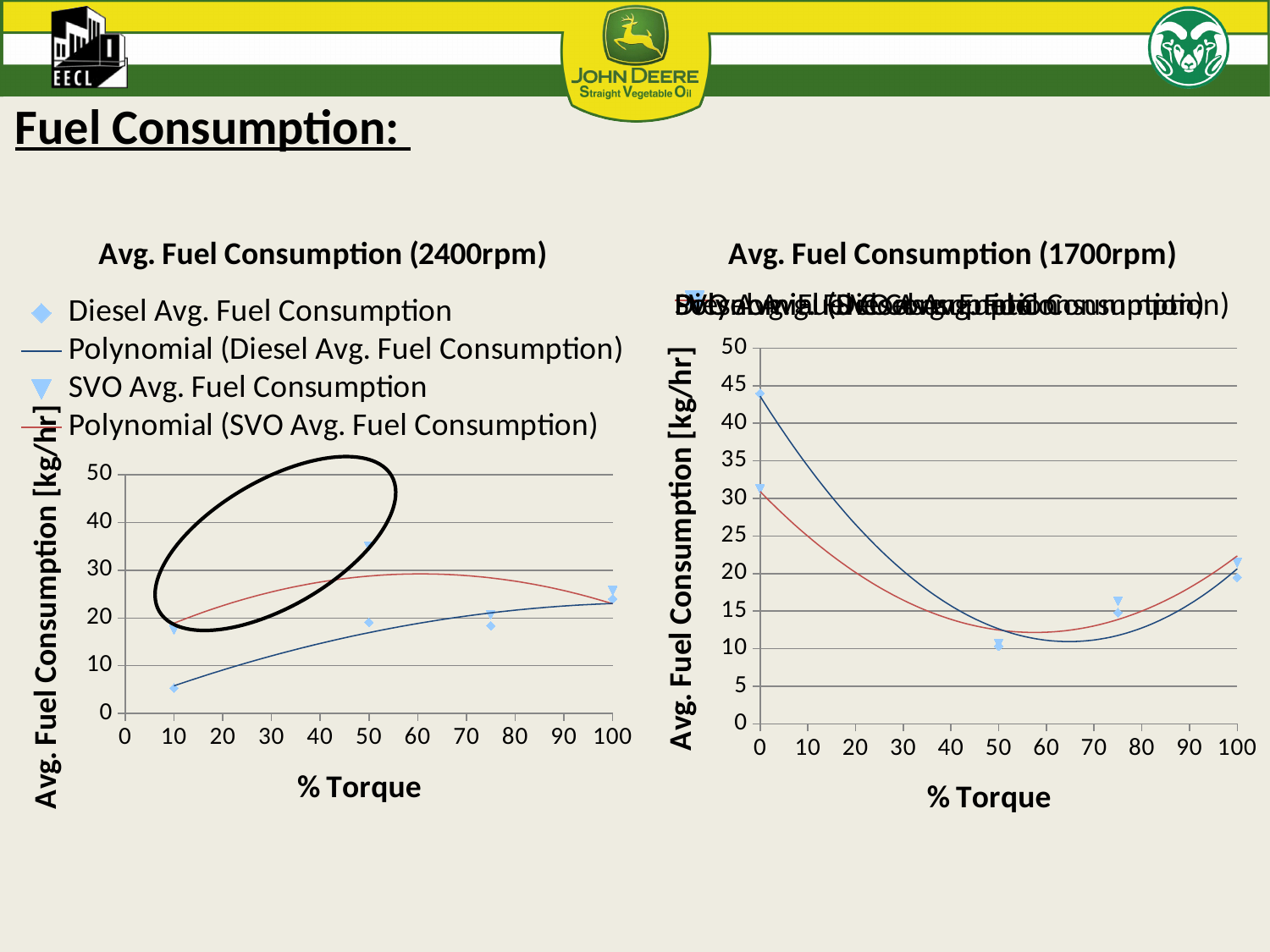
What is the x-axis label of the Avg. Fuel Consumption (1700rpm) chart on the right? % Torque In the Avg. Fuel Consumption (1700rpm) chart on the right, at which % torque are the plotted fuel consumption values lowest? 50 In the Avg. Fuel Consumption (2400rpm) chart, is the Diesel Avg. Fuel Consumption value at 10% torque greater or less than 10? less How many data points are plotted for the Diesel Avg. Fuel Consumption series in the Avg. Fuel Consumption (2400rpm) chart? 4 In the Avg. Fuel Consumption (1700rpm) chart on the right, is the highest plotted value at 0% torque greater or less than 40? greater What kind of chart is the Avg. Fuel Consumption (2400rpm) chart on the left? Scatter chart with polynomial trendlines How many entries does the legend of the Avg. Fuel Consumption (2400rpm) chart list? 4 In the Avg. Fuel Consumption (2400rpm) chart, at which % torque is the Diesel Avg. Fuel Consumption lowest? 10 In the Avg. Fuel Consumption (1700rpm) chart on the right, are the plotted values at 50% torque greater or less than 15? less In the Avg. Fuel Consumption (2400rpm) chart, at 10% torque, which is larger: Diesel Avg. Fuel Consumption or SVO Avg. Fuel Consumption? SVO Avg. Fuel Consumption In the Avg. Fuel Consumption (2400rpm) chart, at which % torque is the SVO Avg. Fuel Consumption highest? 50